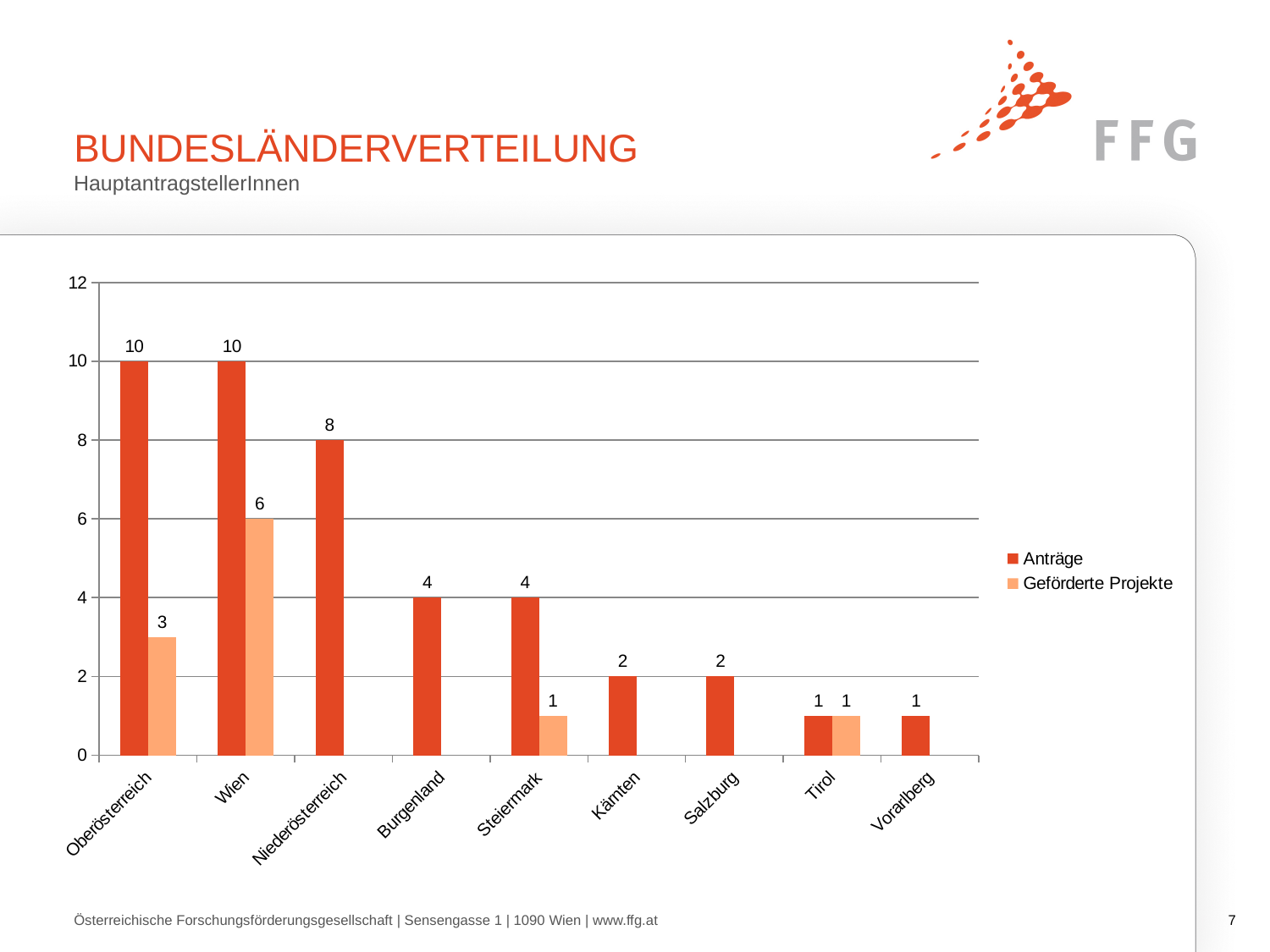
How many series does the legend list? 2 What is the value of Geförderte Projekte for Wien? 6 Which is larger: Anträge for Steiermark or Anträge for Kärnten? Anträge for Steiermark Which Bundesland has the highest value for Geförderte Projekte? Wien What is the difference between Anträge for Niederösterreich and Anträge for Burgenland? 4 What kind of chart is shown on the slide? Bar chart Do the Anträge values generally rise or fall from left to right along the x axis? Fall What is the value of Anträge for Niederösterreich? 8 How many Bundesländer are shown on the x axis? 9 What is the difference between Anträge and Geförderte Projekte for Oberösterreich? 7 What is the value of Geförderte Projekte for Oberösterreich? 3 What is the title of the slide containing the chart? BUNDESLÄNDERVERTEILUNG